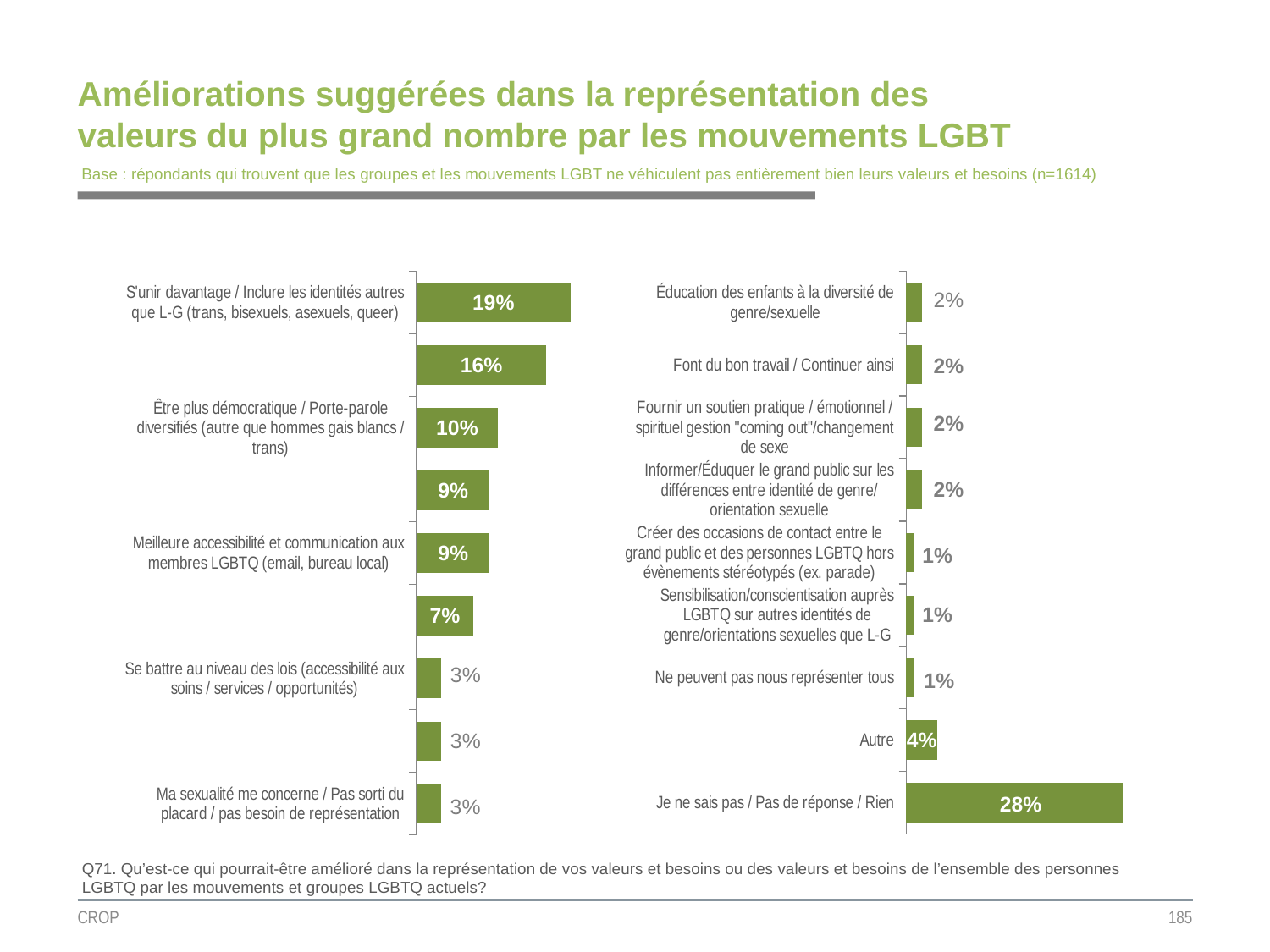
In the right chart, what percentage is shown for 'Autre'? 4% In the right chart, what is the value for 'Ne peuvent pas nous représenter tous'? 1% In the left chart, what is the value for 'Être plus démocratique / Porte-parole diversifiés (autre que hommes gais blancs / trans)'? 10% In the left chart, what percentage is shown for 'Meilleure accessibilité et communication aux membres LGBTQ (email, bureau local)'? 9% How many bars are plotted in the right chart? 9 In the right chart, what is the value for 'Je ne sais pas / Pas de réponse / Rien'? 28% In the left chart, what percentage is shown for 'S'unir davantage / Inclure les identités autres que L-G (trans, bisexuels, asexuels, queer)'? 19% In the right chart, which is larger: the value for 'Autre' or the value for 'Font du bon travail / Continuer ainsi'? Autre What type of chart is used on this slide? Bar chart In the left chart, what is the difference in percentage points between 'S'unir davantage / Inclure les identités autres que L-G' and 'Être plus démocratique / Porte-parole diversifiés'? 9 percentage points In the left chart, which category has the highest value? S'unir davantage / Inclure les identités autres que L-G (trans, bisexuels, asexuels, queer) In the right chart, which category has the highest value? Je ne sais pas / Pas de réponse / Rien